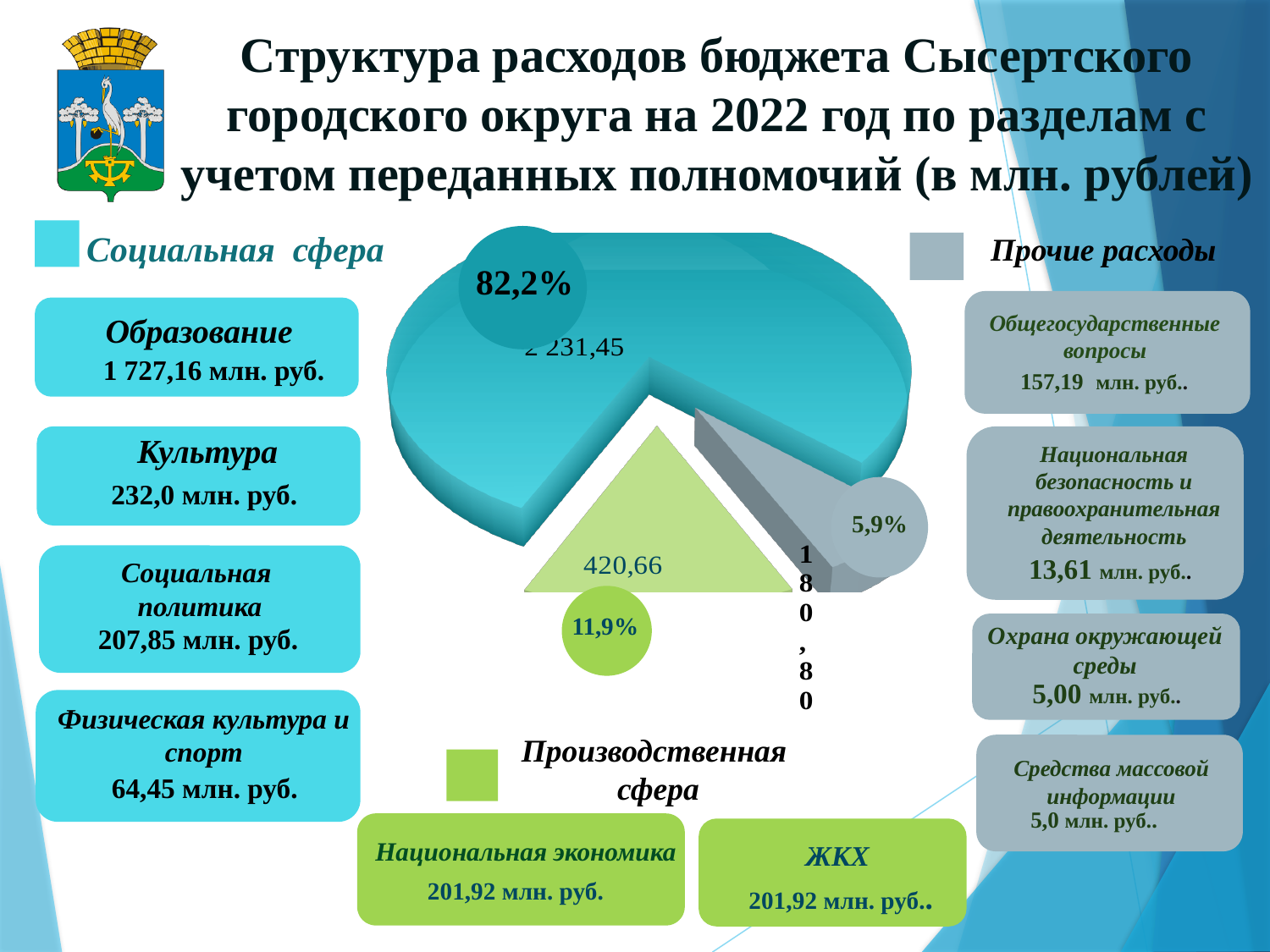
What value is labelled on the Производственная сфера slice? 420,66 Which slice of the pie chart is the smallest? Прочие расходы What share of the pie does Производственная сфера account for? 11,9% Which slice of the pie chart is the largest? Социальная сфера What is the difference between the values for Производственная сфера (420,66) and Прочие расходы (180,80)? 239,86 How many slices does the pie chart have? 3 Which is larger, the value for Производственная сфера or the value for Прочие расходы? Производственная сфера What share of the pie does Социальная сфера account for? 82,2% What kind of chart is shown on the slide? Pie chart What value is labelled on the Прочие расходы slice? 180,80 What value is labelled on the Социальная сфера slice? 2 231,45 What share of the pie does Прочие расходы account for? 5,9%